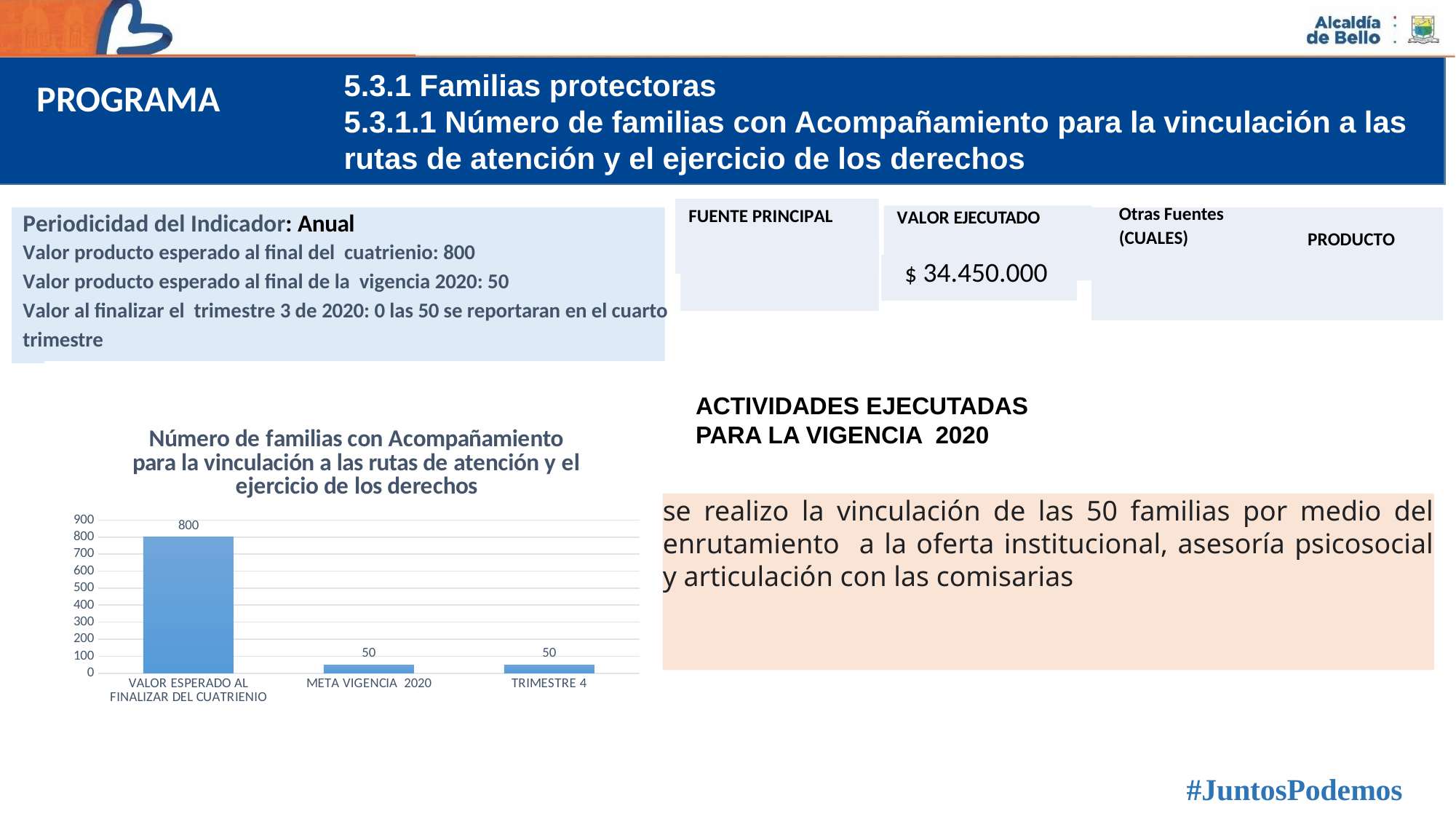
What is the highest value shown on the vertical axis of the chart? 900 Is the value for VALOR ESPERADO AL FINALIZAR DEL CUATRIENIO greater or less than 500? greater Which category has the highest value? VALOR ESPERADO AL FINALIZAR DEL CUATRIENIO How many categories are shown in the chart? 3 Which is larger, the value for VALOR ESPERADO AL FINALIZAR DEL CUATRIENIO or the value for TRIMESTRE 4? VALOR ESPERADO AL FINALIZAR DEL CUATRIENIO Is the value for META VIGENCIA 2020 greater or less than 100? less What is the value for VALOR ESPERADO AL FINALIZAR DEL CUATRIENIO? 800 What is the title of the chart? Número de familias con Acompañamiento para la vinculación a las rutas de atención y el ejercicio de los derechos What is the difference between the value for VALOR ESPERADO AL FINALIZAR DEL CUATRIENIO and the value for META VIGENCIA 2020? 750 What is the value for META VIGENCIA 2020? 50 What is the value for TRIMESTRE 4? 50 What kind of chart is shown on the slide? bar chart